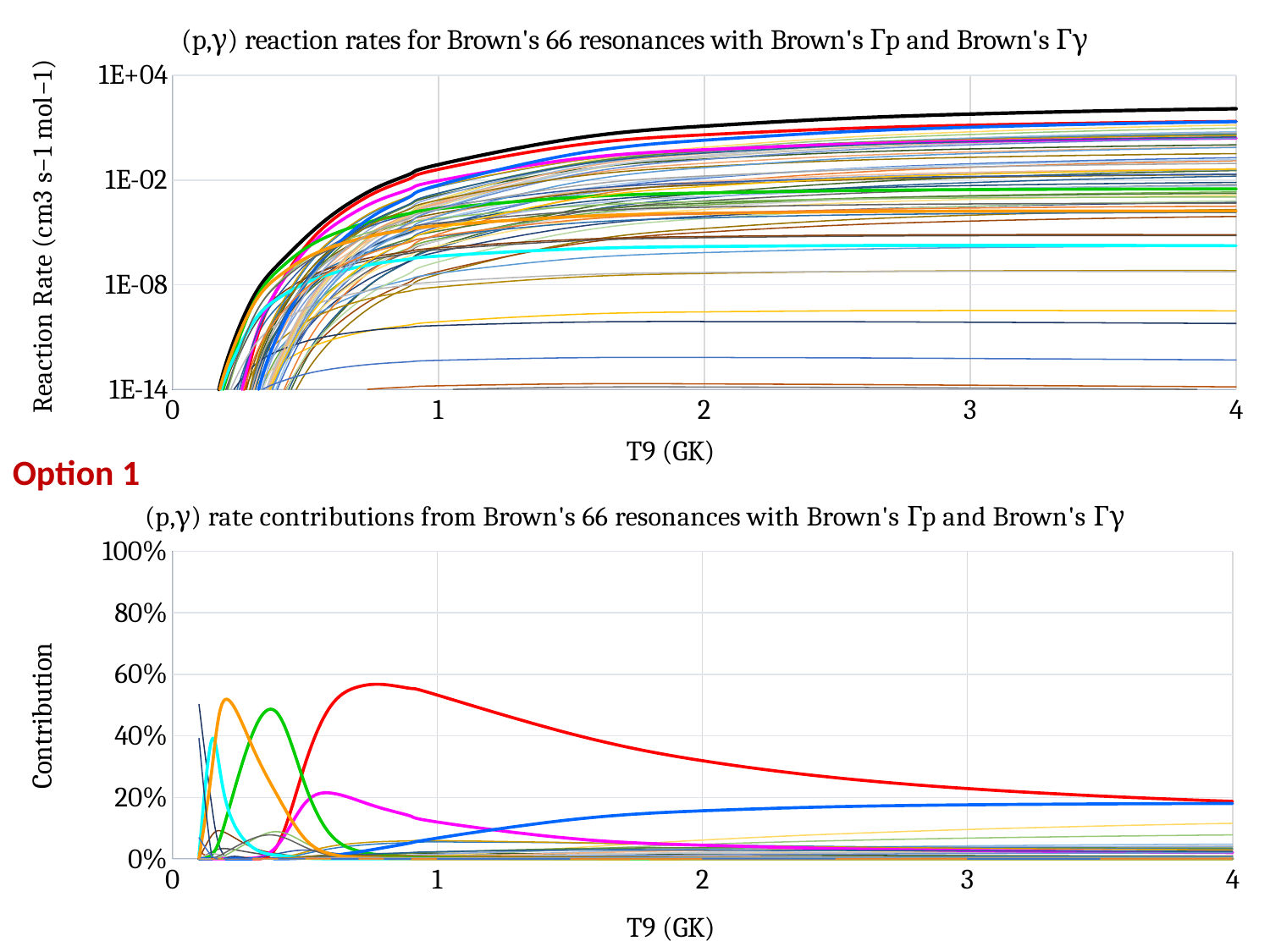
What is the y-axis label of the top chart? Reaction Rate (cm3 s-1 mol-1) In the bottom chart (rate contributions), does the red line rise or fall as T9 increases from 1 to 4? Fall In the top chart (reaction rates), do the reaction rates rise or fall as T9 increases from 0 to 4? Rise In the bottom chart (rate contributions), is the peak contribution of the orange line greater or less than 40%? greater In the bottom chart (rate contributions), which reaches a higher peak contribution, the red line or the green line? The red line In the top chart (reaction rates), which coloured line has the highest reaction rate across the whole temperature range? The black line In the top chart (reaction rates), is the value of the cyan line at T9 = 4 greater or less than 1E-02? less What kind of chart is the bottom chart, titled "(p,γ) rate contributions from Brown's 66 resonances with Brown's Γp and Brown's Γγ"? Line chart What kind of chart is the top chart, titled "(p,γ) reaction rates for Brown's 66 resonances with Brown's Γp and Brown's Γγ"? Line chart In the top chart (reaction rates), is the value of the black line at T9 = 4 greater or less than 1E-02? greater